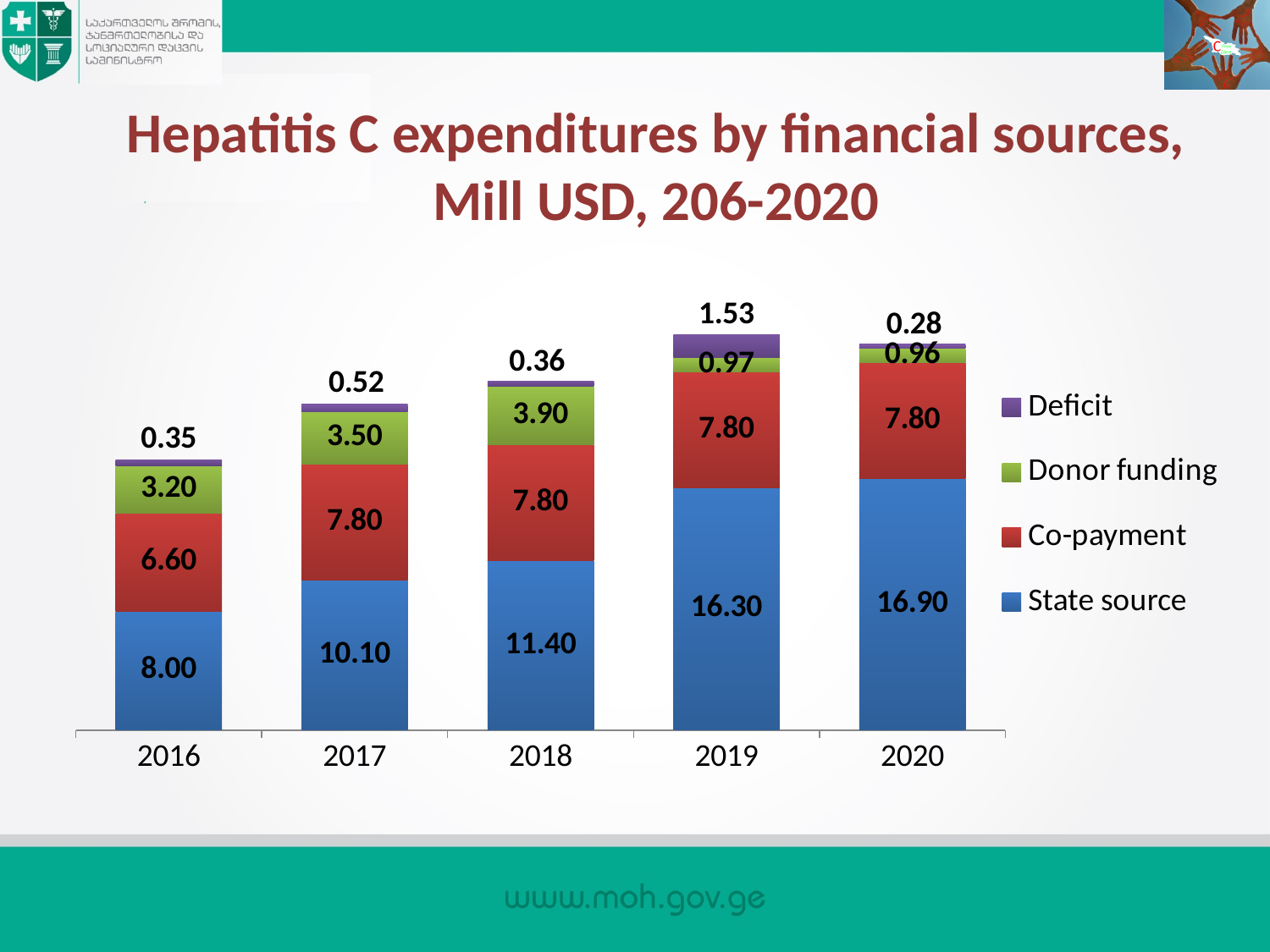
What is the difference between the State source values for 2019 and 2016? 8.30 How many years are shown on the x axis? 5 What is the total of the stacked bar for 2016? 18.15 Which year has the lowest Deficit value? 2020 What is the Co-payment value for 2016? 6.60 How many series does the legend list? 4 Which is larger, the Donor funding value for 2018 or for 2020? 2018 What is the State source value for 2018? 11.40 What kind of chart is shown on the slide? Stacked bar chart What is the Donor funding value for 2019? 0.97 What is the Deficit value for 2017? 0.52 Which year has the highest State source value? 2020